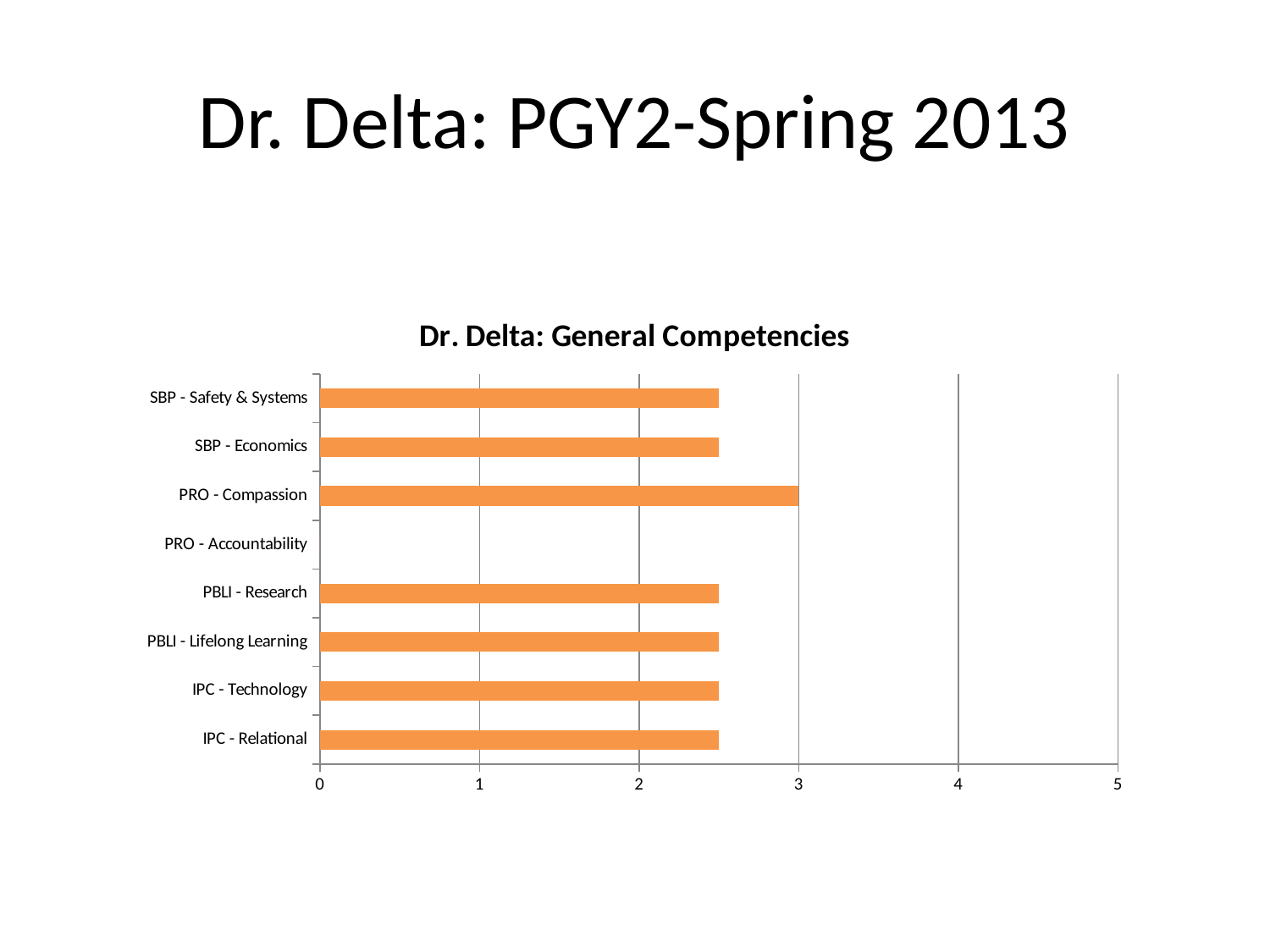
How many categories are listed on the chart's vertical axis? 8 Which category has no bar displayed on the chart? PRO - Accountability Which is larger, the value for PRO - Compassion or the value for IPC - Technology? PRO - Compassion Which category has the highest value? PRO - Compassion Is the value for SBP - Economics greater or less than 2? greater Is the value for IPC - Relational greater or less than 3? less What is the maximum value shown on the horizontal axis? 5 What is the title of the chart? Dr. Delta: General Competencies Is the value for PBLI - Research greater or less than 4? less What is the value for PRO - Compassion? 3 What type of chart is shown on the slide? bar chart